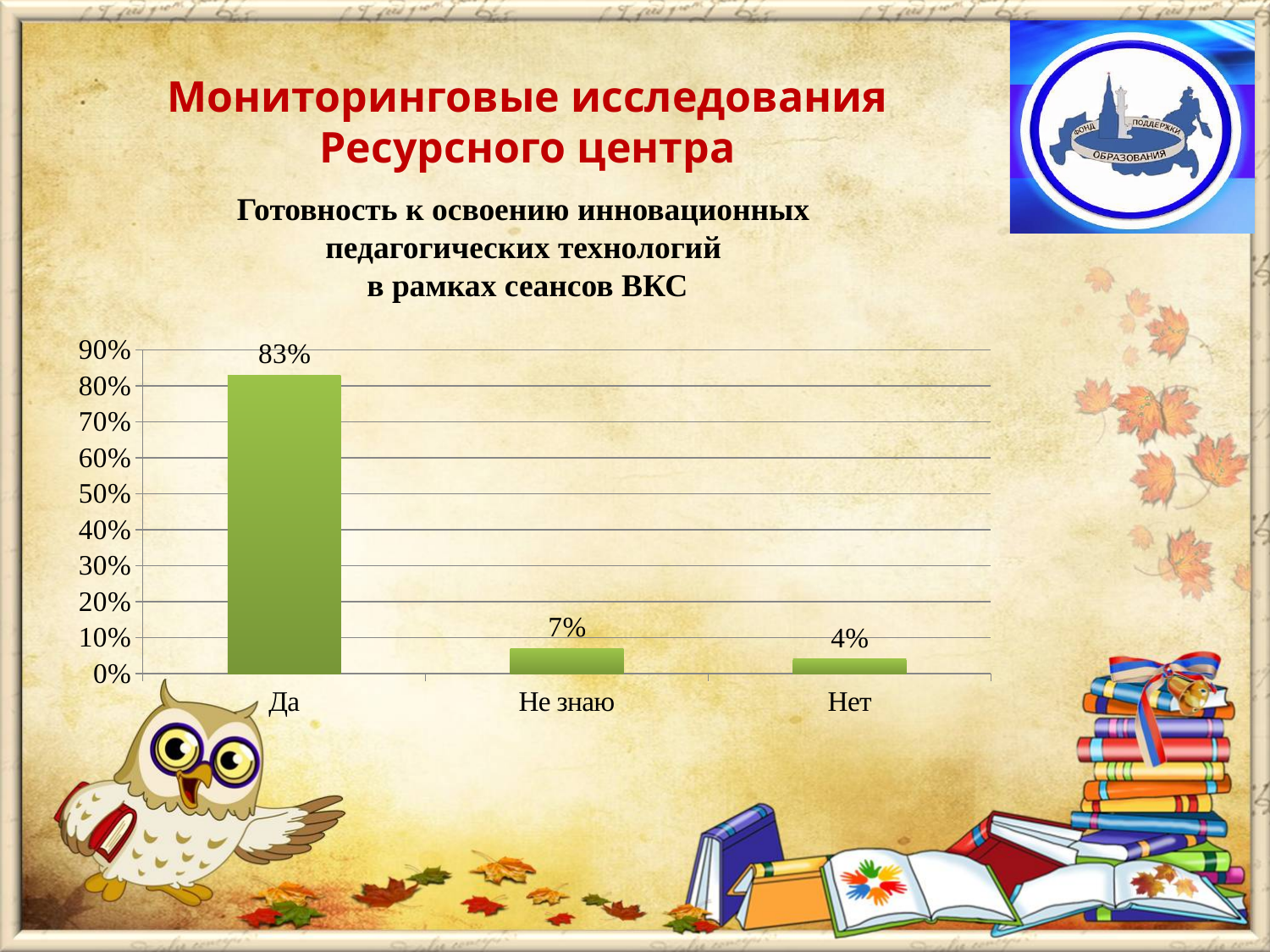
Is the value for "Да" greater or less than 80%? greater What is the value for "Да"? 83% What is the value for "Не знаю"? 7% Which category has the lowest value? Нет What is the difference between the values for "Не знаю" and "Нет"? 3% Which category has the highest value? Да What kind of chart is shown on the slide? bar chart What is the difference between the values for "Да" and "Не знаю"? 76% How many categories are shown on the x axis? 3 What is the value for "Нет"? 4% What is the title of the chart? Готовность к освоению инновационных педагогических технологий в рамках сеансов ВКС Which is larger, the value for "Не знаю" or the value for "Нет"? Не знаю